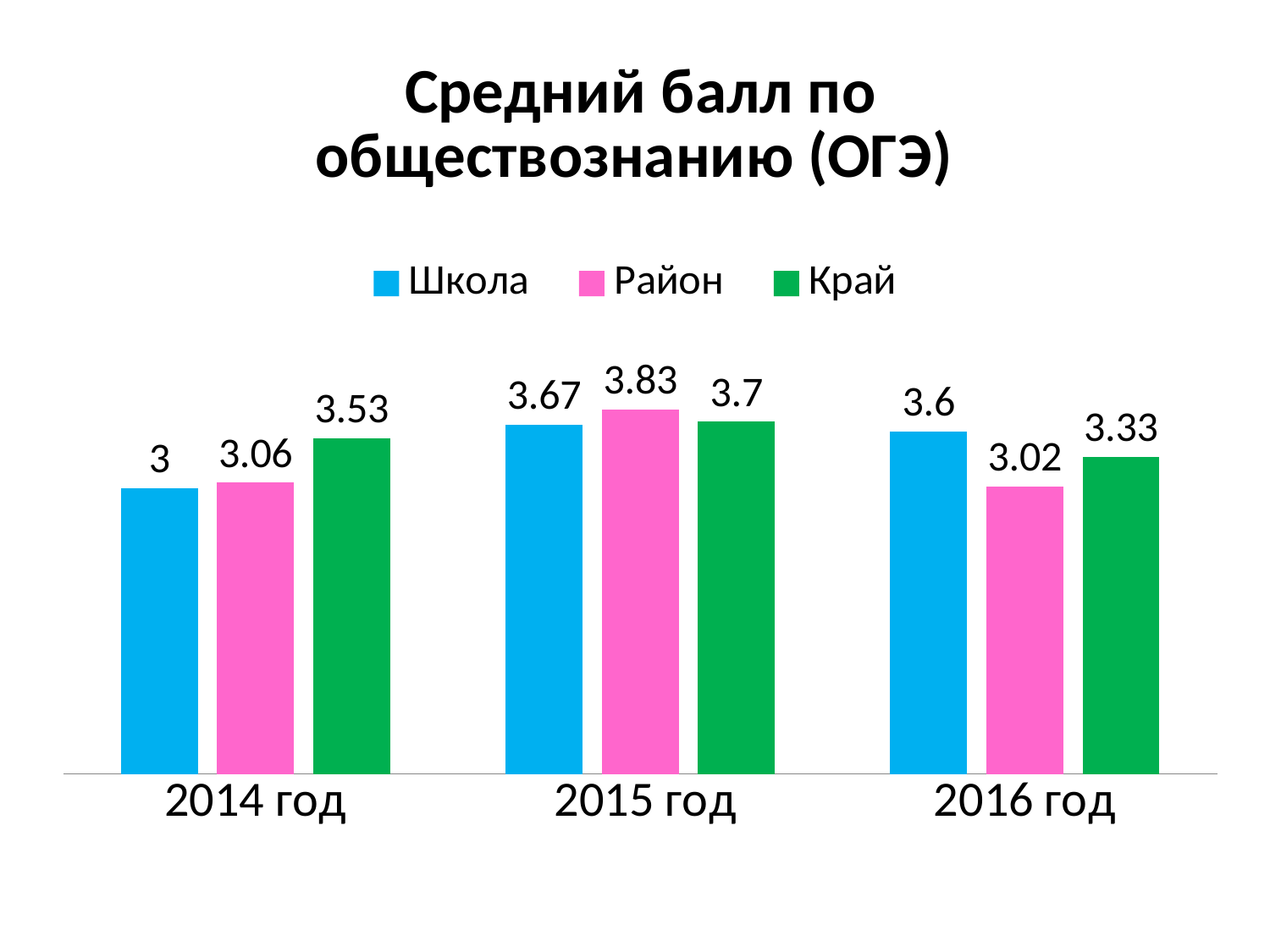
What is the value for Школа in 2016 год? 3.6 In which year is the value for Край lowest? 2016 год How many year categories are shown on the x axis? 3 What is the value for Район in 2015 год? 3.83 What is the difference between the Край and Школа values in 2014 год? 0.53 What is the value for Край in 2016 год? 3.33 What is the title of the chart? Средний балл по обществознанию (ОГЭ) What is the value for Школа in 2014 год? 3 Which is larger in 2016 год: Школа or Район? Школа In which year is the value for Район highest? 2015 год How many series does the legend list? 3 What kind of chart is shown on the slide? Bar chart